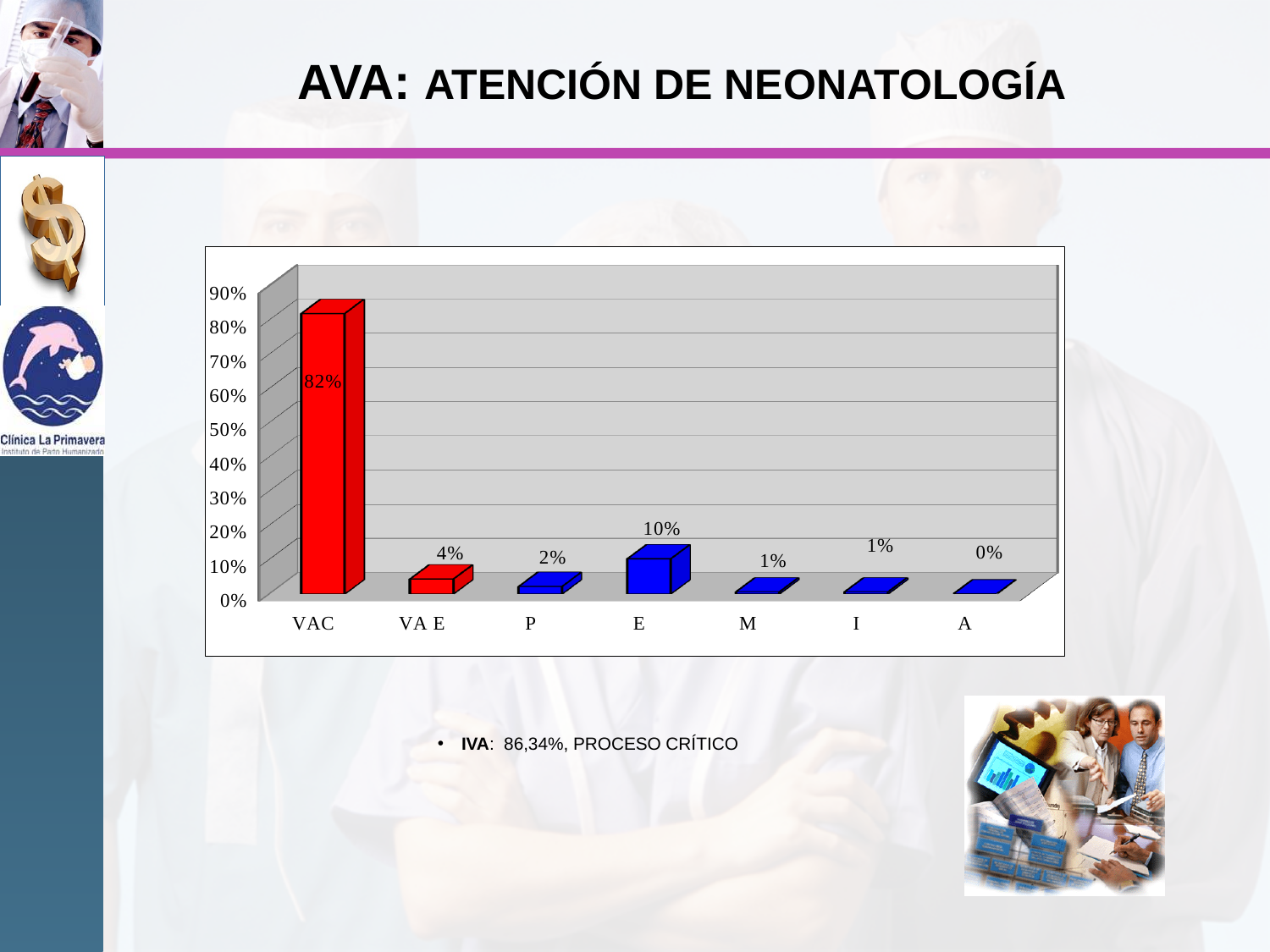
What is the difference between the values for VAC and E? 72% What is the value for E? 10% What kind of chart is shown on the slide? bar chart Which category has the lowest value? A Which is larger, the value for VA E or the value for P? VA E How many categories are shown on the x axis? 7 Which category has the highest value? VAC What is the value for P? 2% What is the value for VAC? 82% What is the value for A? 0% What colour is the bar for VAC? red What is the value for VA E? 4%